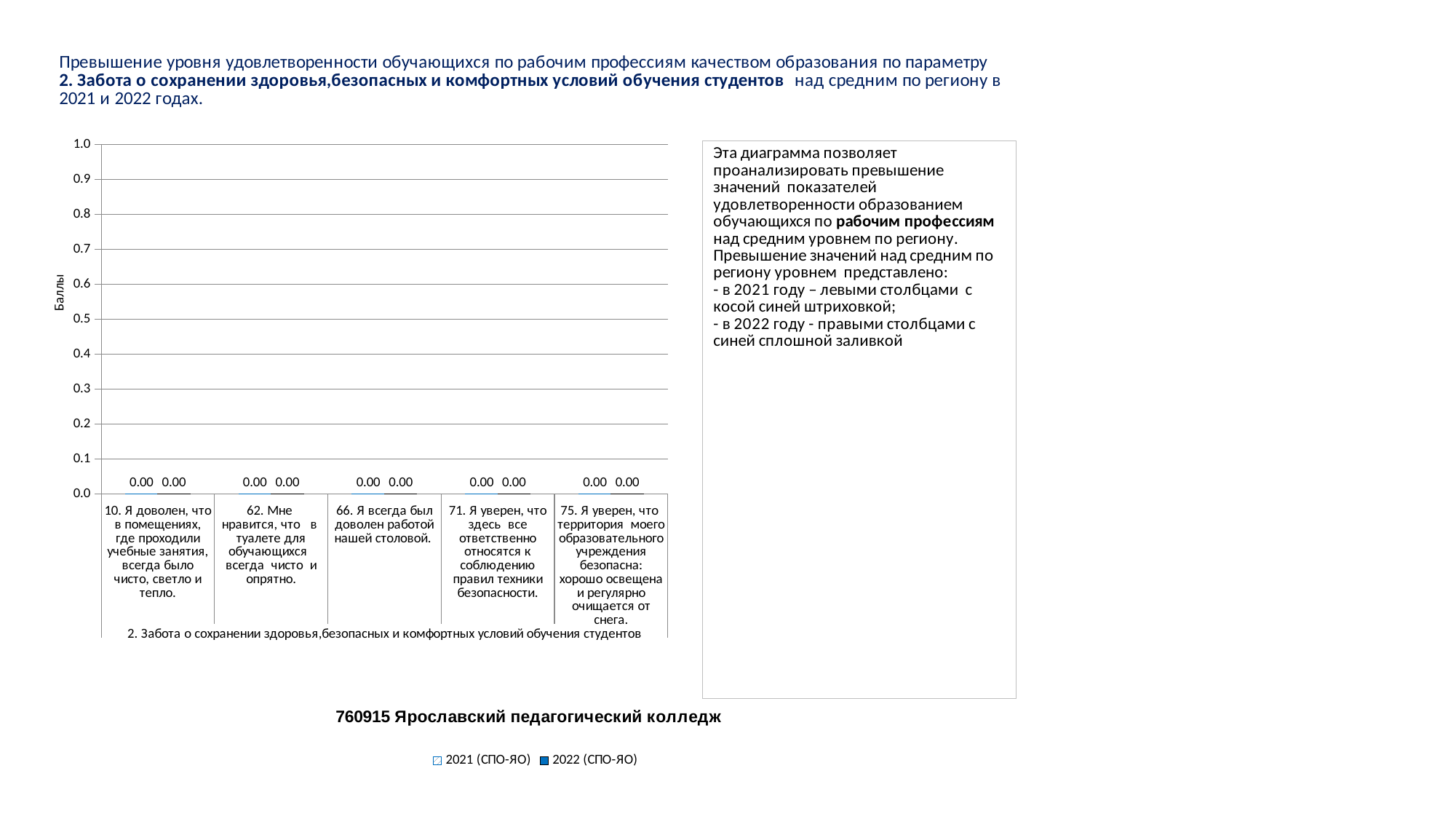
What is the value for 2022 (СПО-ЯО) for category 62 (Мне нравится, что в туалете для обучающихся всегда чисто и опрятно)? 0.00 What is the value for 2021 (СПО-ЯО) for category 10 (Я доволен, что в помещениях, где проходили учебные занятия, всегда было чисто, светло и тепло)? 0.00 How many categories are shown on the x axis? 5 Do the values for 2021 (СПО-ЯО) rise, fall, or stay the same across the categories along the x axis? stay the same What is the difference between the 2021 (СПО-ЯО) and 2022 (СПО-ЯО) values for category 71 (Я уверен, что здесь все ответственно относятся к соблюдению правил техники безопасности)? 0.00 How many series does the legend list? 2 Is the value for 2022 (СПО-ЯО) for category 71 greater or less than 0.5? less What type of chart is shown on the slide? bar chart What is the value for 2021 (СПО-ЯО) for category 75 (Я уверен, что территория моего образовательного учреждения безопасна)? 0.00 What is the label of the y axis? Баллы What is the value for 2022 (СПО-ЯО) for category 66 (Я всегда был доволен работой нашей столовой)? 0.00